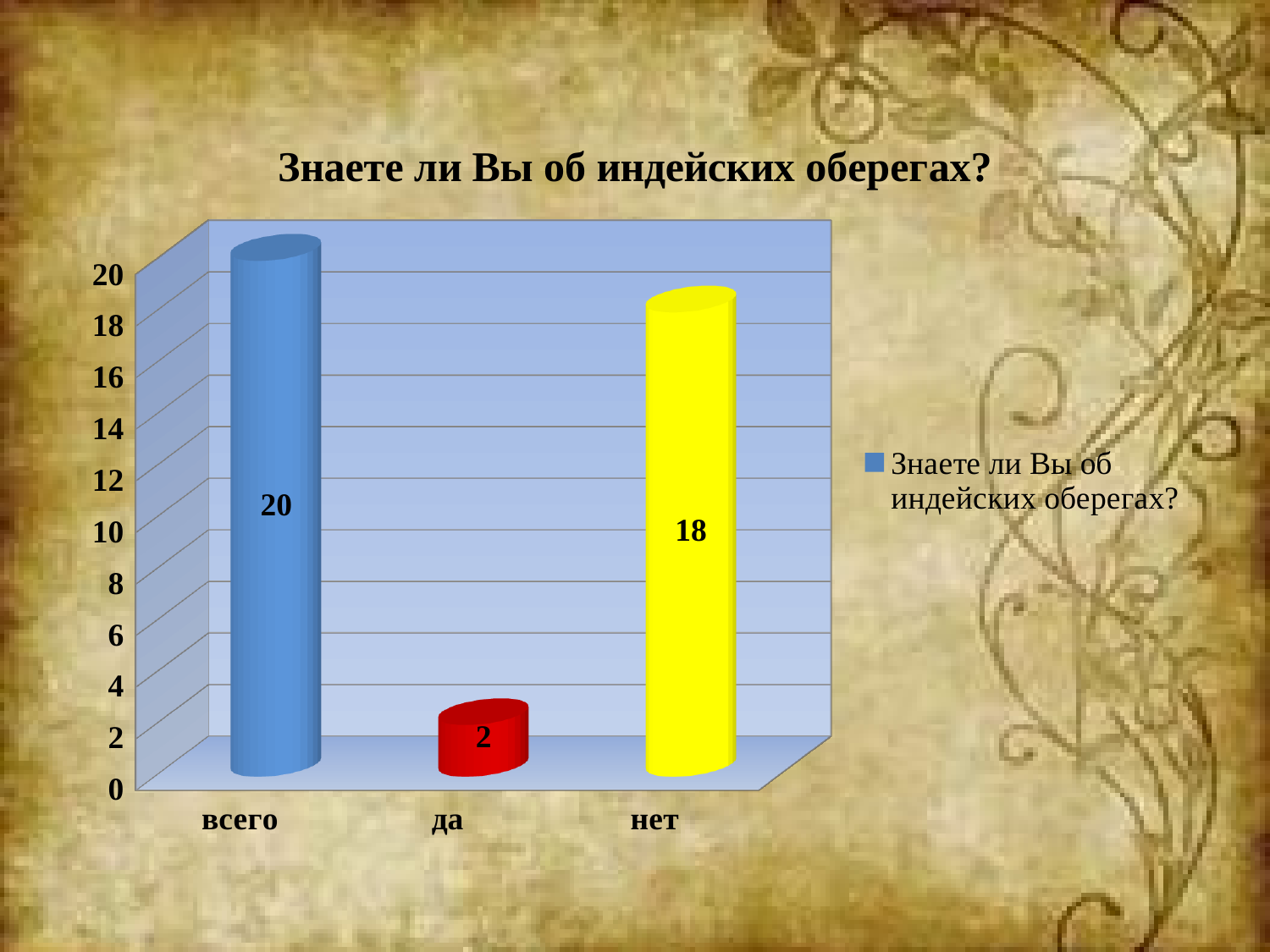
Is the value for "нет" greater or less than 10? greater Which is larger, the value for "да" or the value for "нет"? нет How many categories are shown on the x axis? 3 What is the value for "да"? 2 What is the title of the chart? Знаете ли Вы об индейских оберегах? What is the value for "всего"? 20 What is the difference between the values for "нет" and "да"? 16 What is the difference between the values for "всего" and "нет"? 2 Which category has the lowest value? да What is the value for "нет"? 18 What kind of chart is shown on the slide? bar chart Which category has the highest value? всего